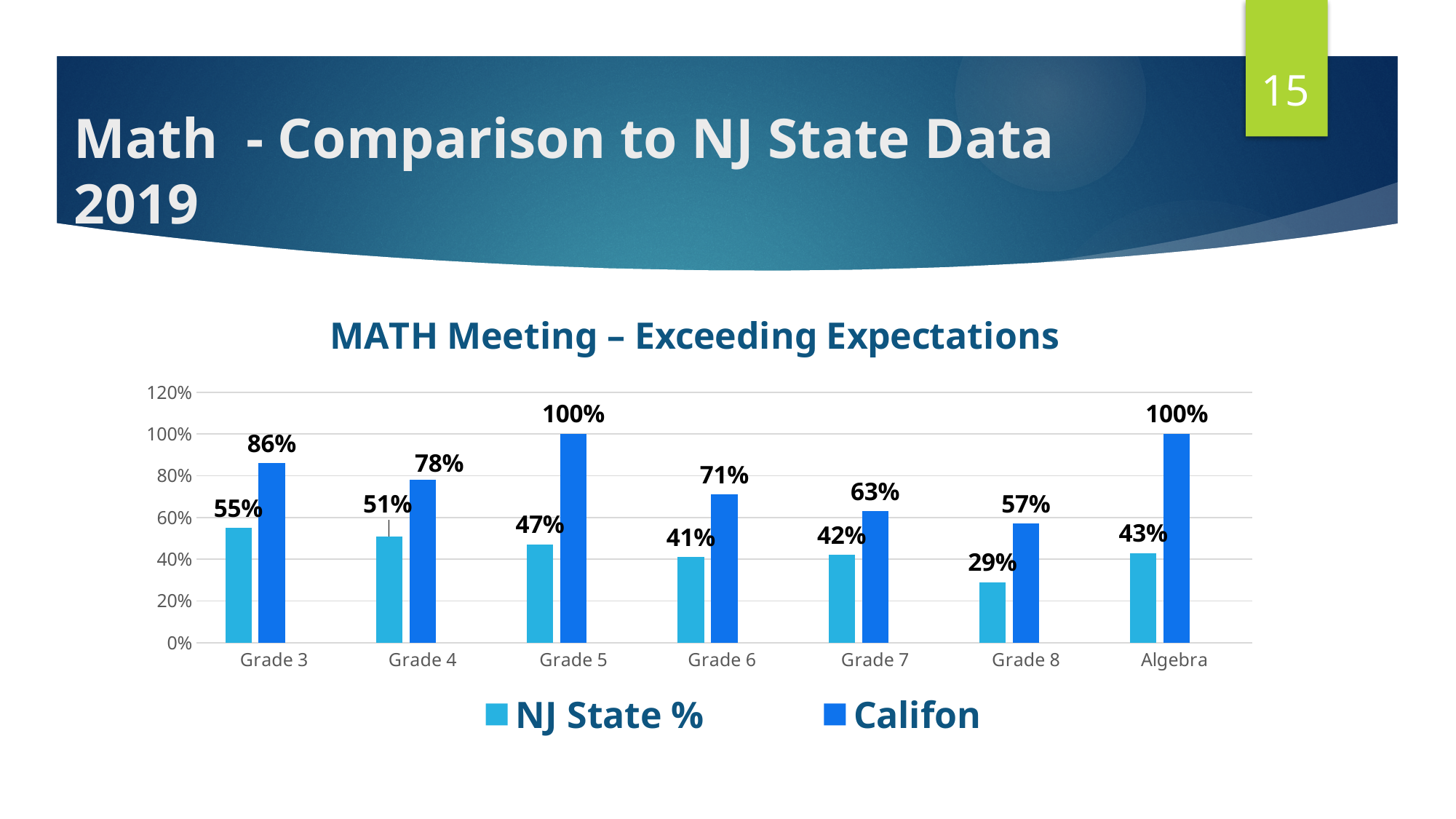
Which category has the highest NJ State % value? Grade 3 How many series does the legend list? 2 How many categories are shown on the x axis? 7 What is the Califon value for Grade 5? 100% Which is larger for Grade 6: the NJ State % value or the Califon value? Califon What is the title of the chart? MATH Meeting – Exceeding Expectations Which category has the lowest NJ State % value? Grade 8 What is the NJ State % value for Grade 8? 29% What is the difference between the Califon and NJ State % values for Grade 3? 31% What is the Califon value for Grade 7? 63% What is the difference between the Califon and NJ State % values for Algebra? 57% What kind of chart is shown on the slide? Bar chart